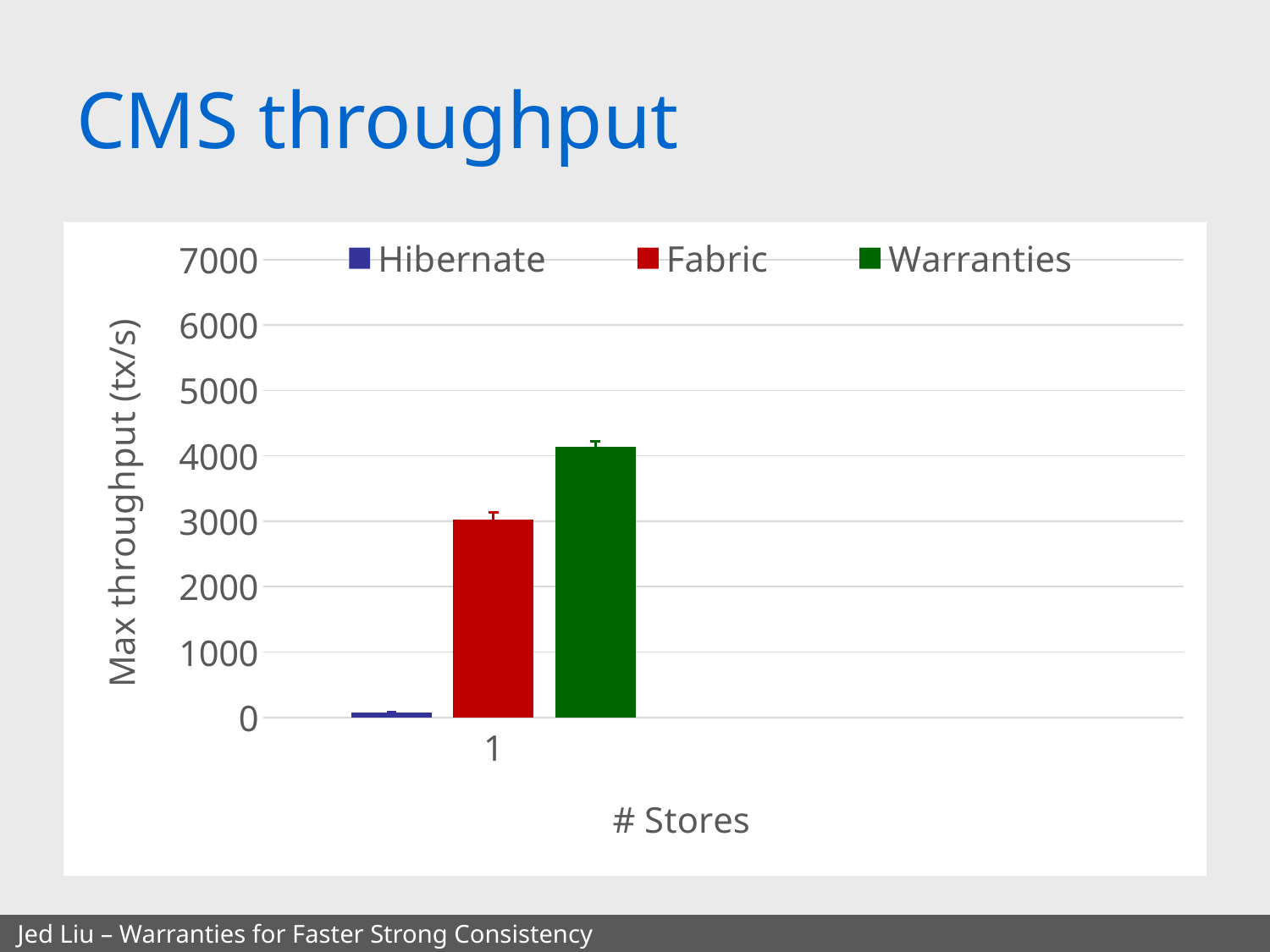
How many series does the legend list? 3 Is the value for Warranties greater or less than 4000? greater Is the value for Fabric greater or less than 2000? greater What kind of chart is shown on the slide? bar chart Which has a higher max throughput, Fabric or Warranties? Warranties How many categories are shown on the x axis? 1 Is the value for Fabric greater or less than 4000? less Which series has the lowest max throughput? Hibernate What is the label of the y axis? Max throughput (tx/s) Which has a higher max throughput, Hibernate or Fabric? Fabric Which series has the highest max throughput? Warranties